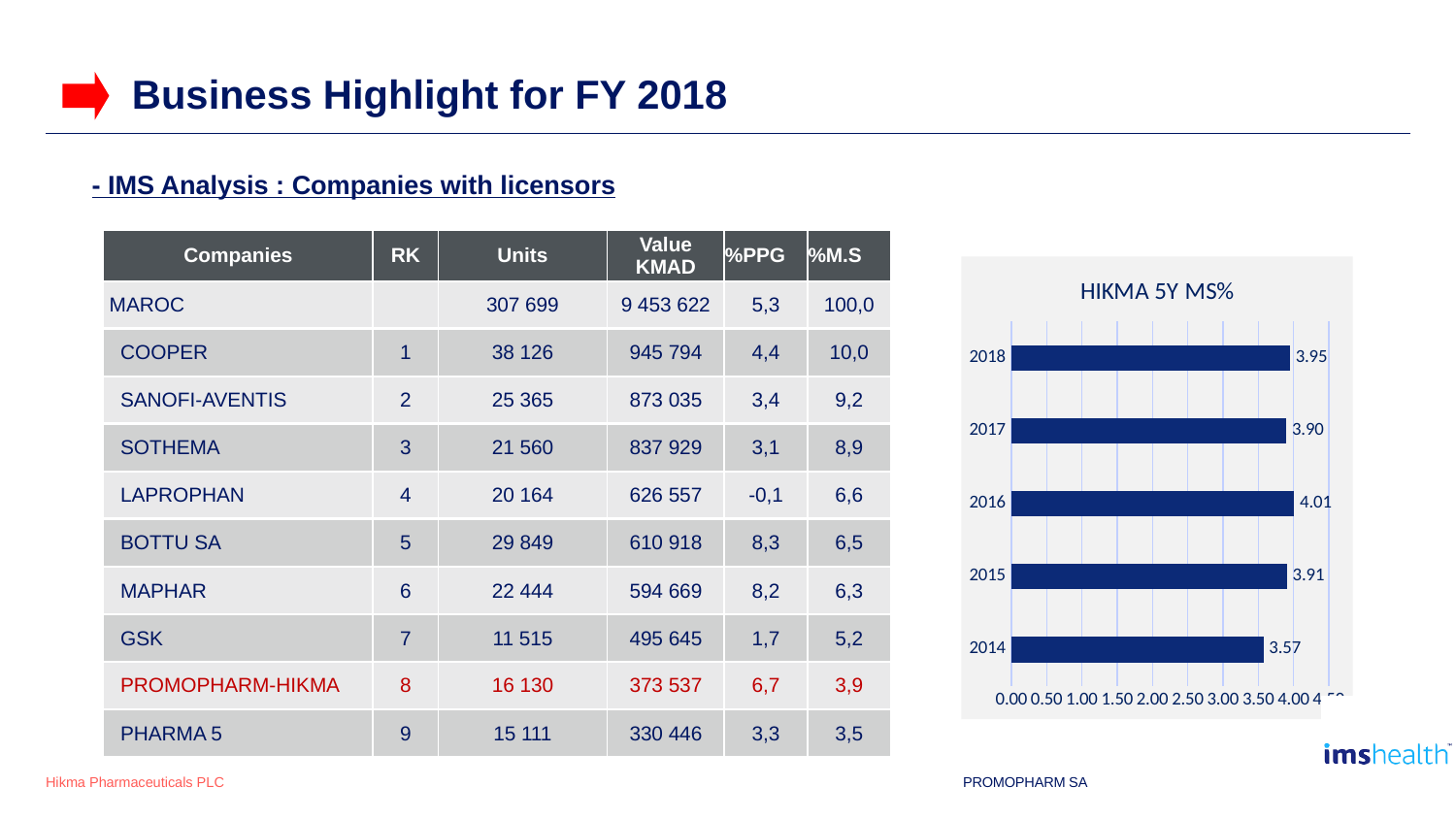
How many years are shown in the HIKMA 5Y MS% chart? 5 What is the value for 2016 in the HIKMA 5Y MS% chart? 4.01 What is the difference between the 2018 and 2017 values in the HIKMA 5Y MS% chart? 0.05 In the HIKMA 5Y MS% chart, which is larger, the value for 2015 or the value for 2014? 2015 What is the value for 2018 in the HIKMA 5Y MS% chart? 3.95 Which year has the lowest value in the HIKMA 5Y MS% chart? 2014 What is the value for 2014 in the HIKMA 5Y MS% chart? 3.57 Which year has the highest value in the HIKMA 5Y MS% chart? 2016 What is the difference between the 2016 and 2014 values in the HIKMA 5Y MS% chart? 0.44 What kind of chart is the HIKMA 5Y MS% chart? bar chart Is the value for 2017 in the HIKMA 5Y MS% chart greater or less than 4.00? less What is the title of the chart on the slide? HIKMA 5Y MS%